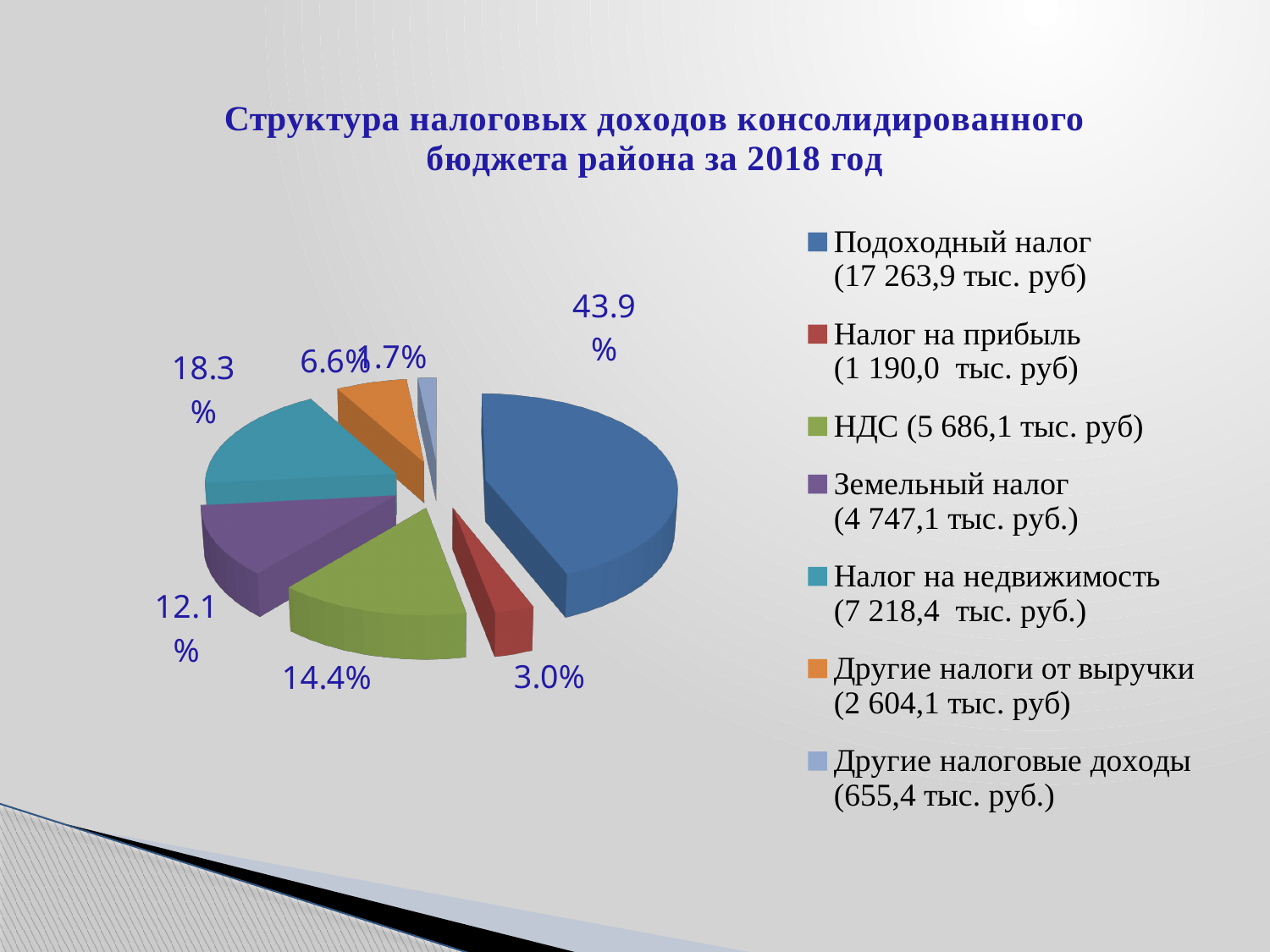
What percentage is shown for Налог на недвижимость? 18.3% What is the difference in percentage points between Подоходный налог and Налог на недвижимость? 25.6 According to the legend, what amount in тыс. руб is given for НДС? 5 686,1 тыс. руб Which category has the smallest slice of the pie? Другие налоговые доходы Which category has the largest slice of the pie? Подоходный налог What percentage is shown for Земельный налог? 12.1% What percentage is shown for НДС? 14.4% What percentage is shown for Налог на прибыль? 3.0% How many categories does the legend list? 7 What share of the pie does Подоходный налог account for? 43.9% Which is larger, the share for НДС or the share for Земельный налог? НДС What kind of chart is shown on the slide? Pie chart